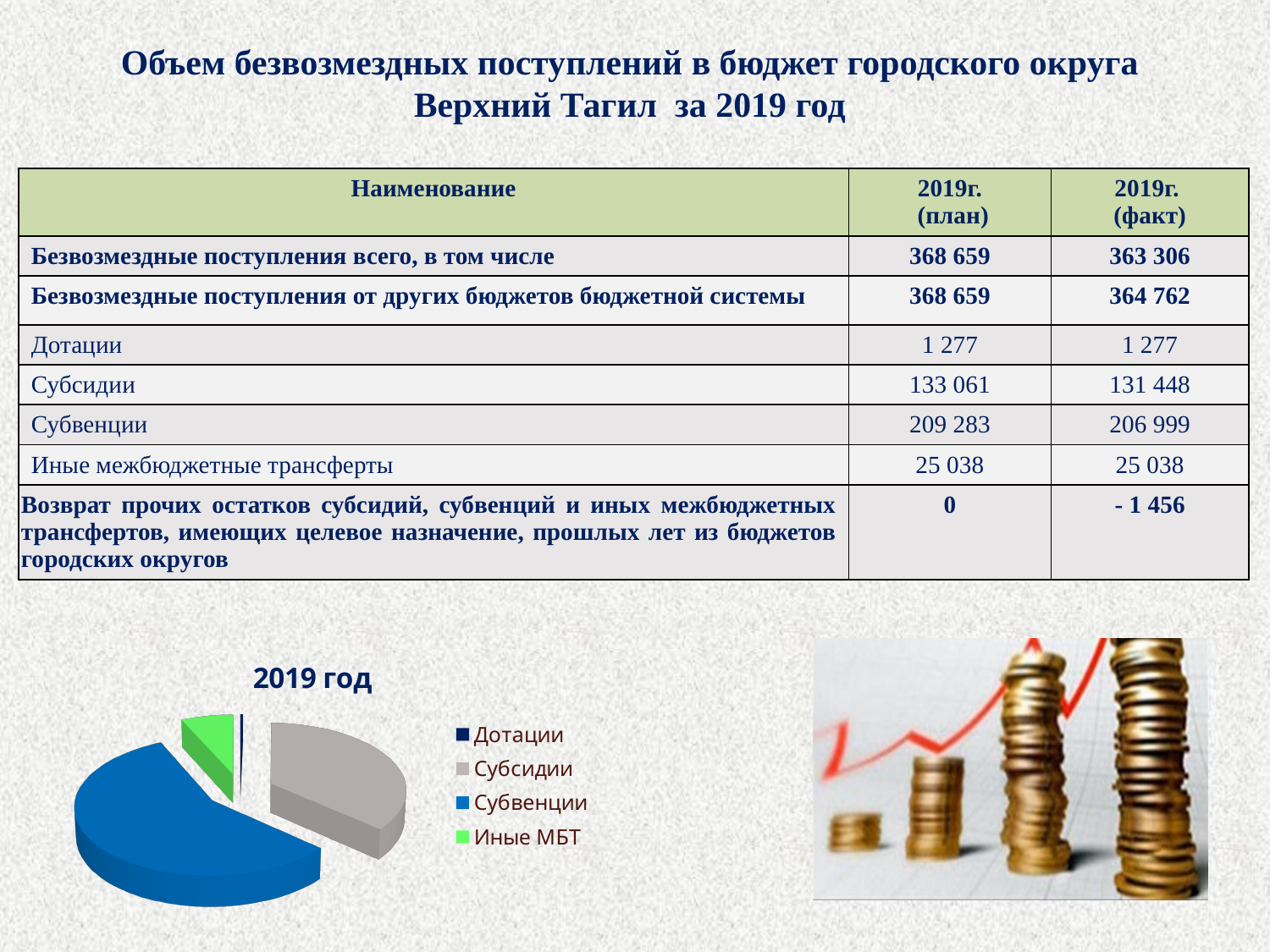
What is the title of the pie chart on the slide? 2019 год What kind of chart is shown on the slide under the heading "2019 год"? pie chart In the pie chart, which slice is larger: Субсидии or Иные МБТ? Субсидии Which colour represents Субвенции in the pie chart? blue In the pie chart, which slice is larger: Субвенции or Субсидии? Субвенции How many slices does the pie chart have? 4 How many entries does the legend of the pie chart list? 4 In the pie chart, which slice is larger: Иные МБТ or Дотации? Иные МБТ Which category has the smallest slice in the pie chart? Дотации Which category has the largest slice in the pie chart? Субвенции